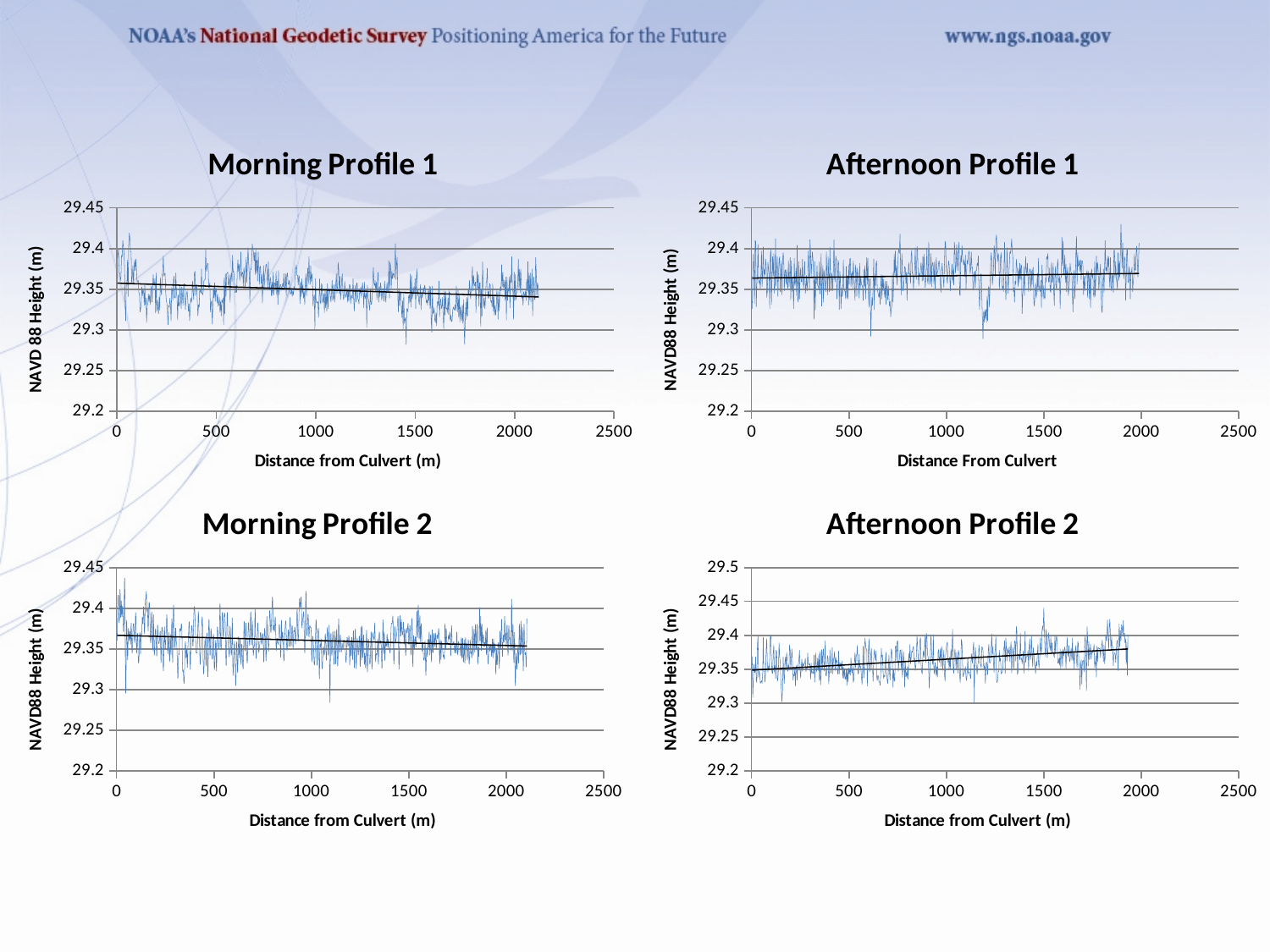
In Morning Profile 1, is the trend line value at 0 m greater or less than 29.3? greater In Afternoon Profile 2, is the trend line value at 1500 m greater or less than 29.35? greater In Morning Profile 2, is the trend line value at 2000 m greater or less than 29.4? less What is the x-axis title of the Morning Profile 1 chart? Distance from Culvert (m) In Morning Profile 1, does the black trend line rise or fall as distance from the culvert increases? fall In Afternoon Profile 1, does the black trend line rise or fall along the x axis? rise In Afternoon Profile 2, does the black trend line rise or fall as distance from the culvert increases? rise In Morning Profile 1, is the trend line higher at 0 m or at 2000 m? 0 m How many charts are shown on the slide? 4 Which chart's y axis extends up to 29.5? Afternoon Profile 2 What kind of chart is Morning Profile 1? line chart